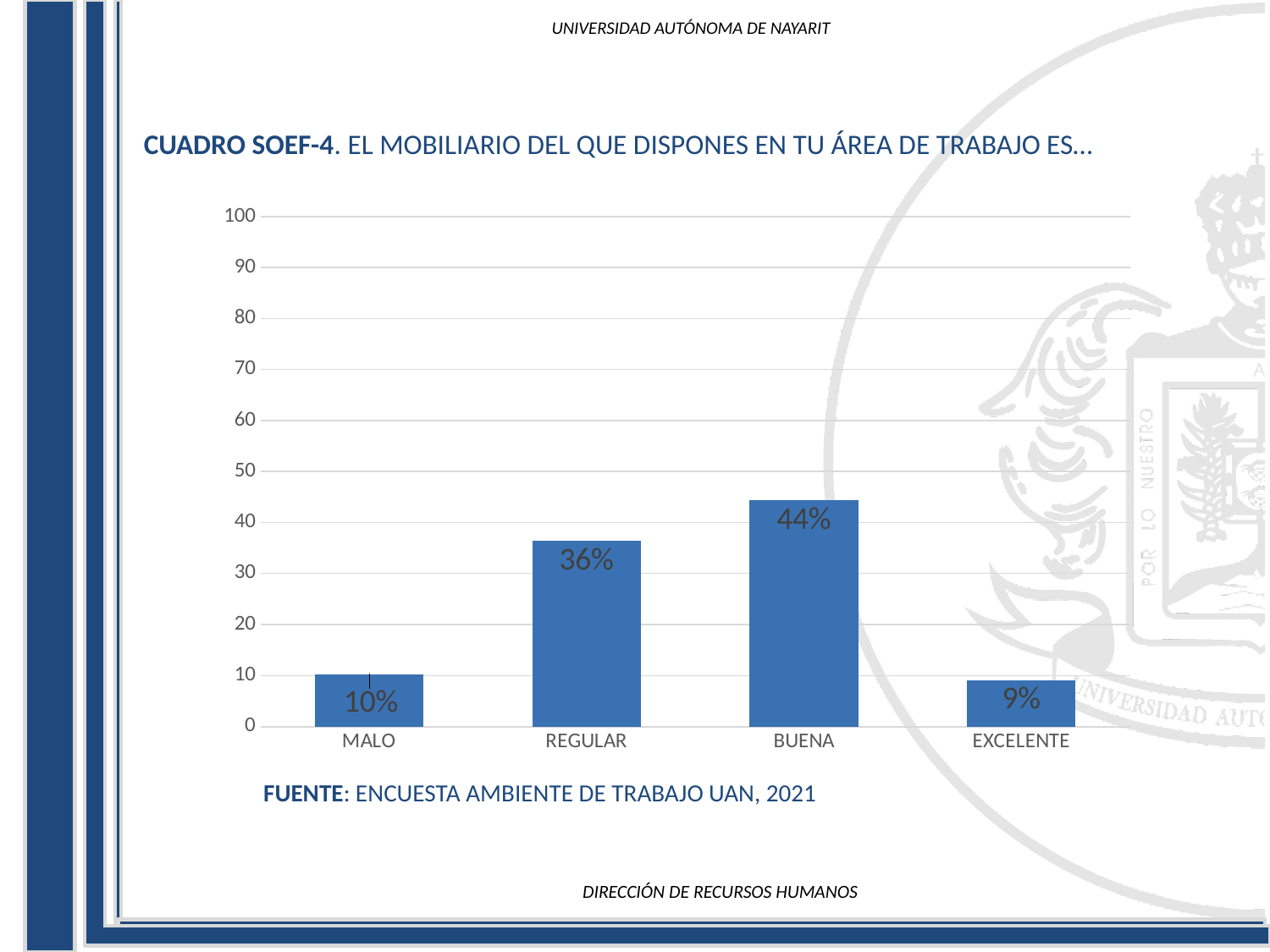
What is the value for MALO? 10% Is the value for REGULAR greater or less than 30? greater How many categories are shown on the x axis? 4 What is the value for BUENA? 44% Which category has the lowest value? EXCELENTE What is the difference between the values for BUENA and REGULAR? 8% What is the value for EXCELENTE? 9% What kind of chart is shown on the slide? bar chart Which category has the highest value? BUENA Which is larger, the value for REGULAR or the value for MALO? REGULAR What is the source cited below the chart? ENCUESTA AMBIENTE DE TRABAJO UAN, 2021 What is the difference between the values for MALO and EXCELENTE? 1%